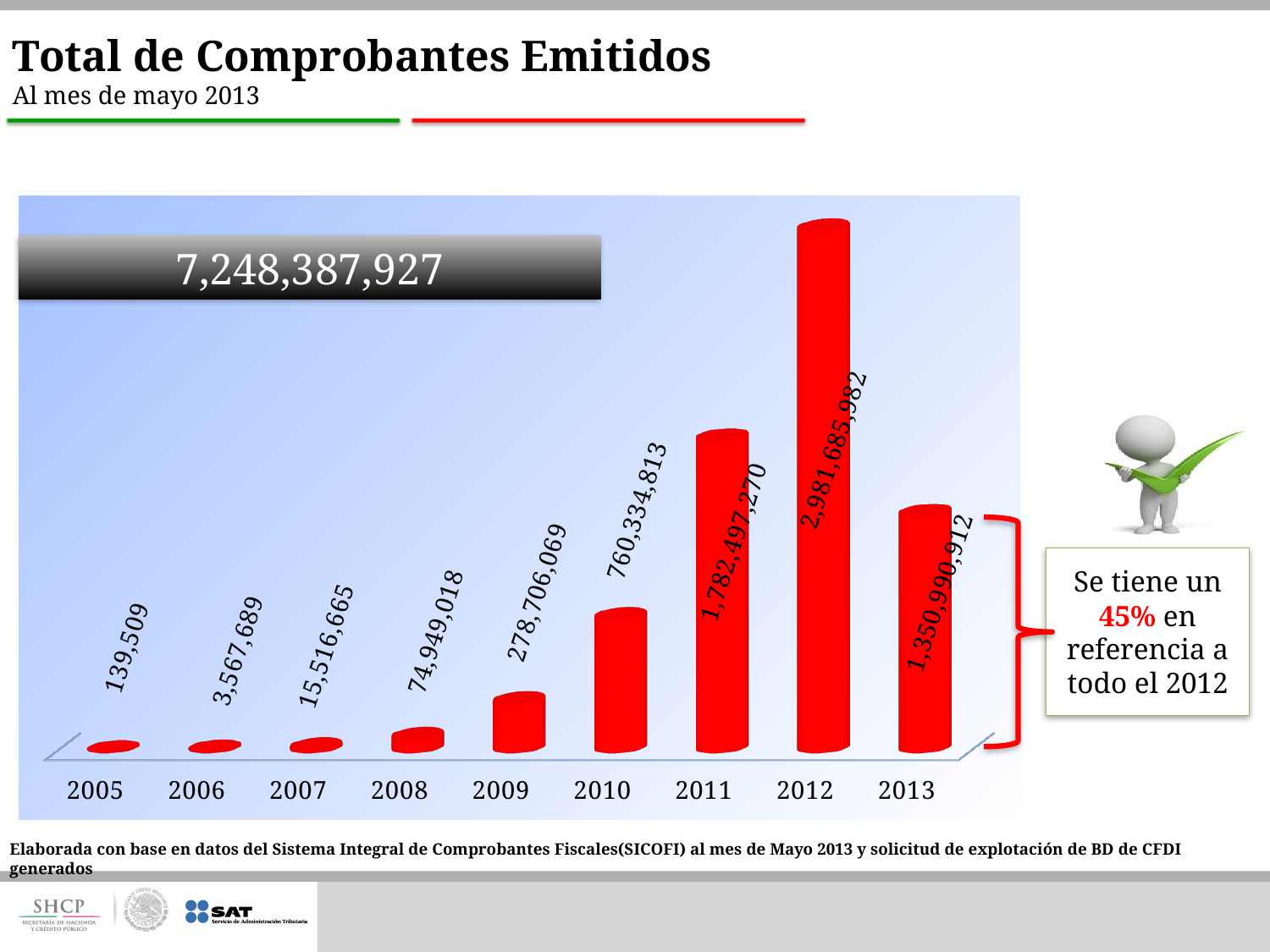
What is the difference between the values for 2012 and 2011? 1,199,188,712 Which is larger, the value for 2011 or the value for 2013? 2011 What total figure is shown in the dark box at the top left of the chart? 7,248,387,927 What is the value for 2013? 1,350,990,912 What is the value for 2012? 2,981,685,982 What type of chart is shown on the slide? Bar chart What is the value for 2009? 278,706,069 Which year has the lowest value? 2005 What is the value for 2005? 139,509 Which year has the highest value? 2012 How many years are shown on the x axis of the chart? 9 Do the values rise or fall from 2005 to 2012? Rise